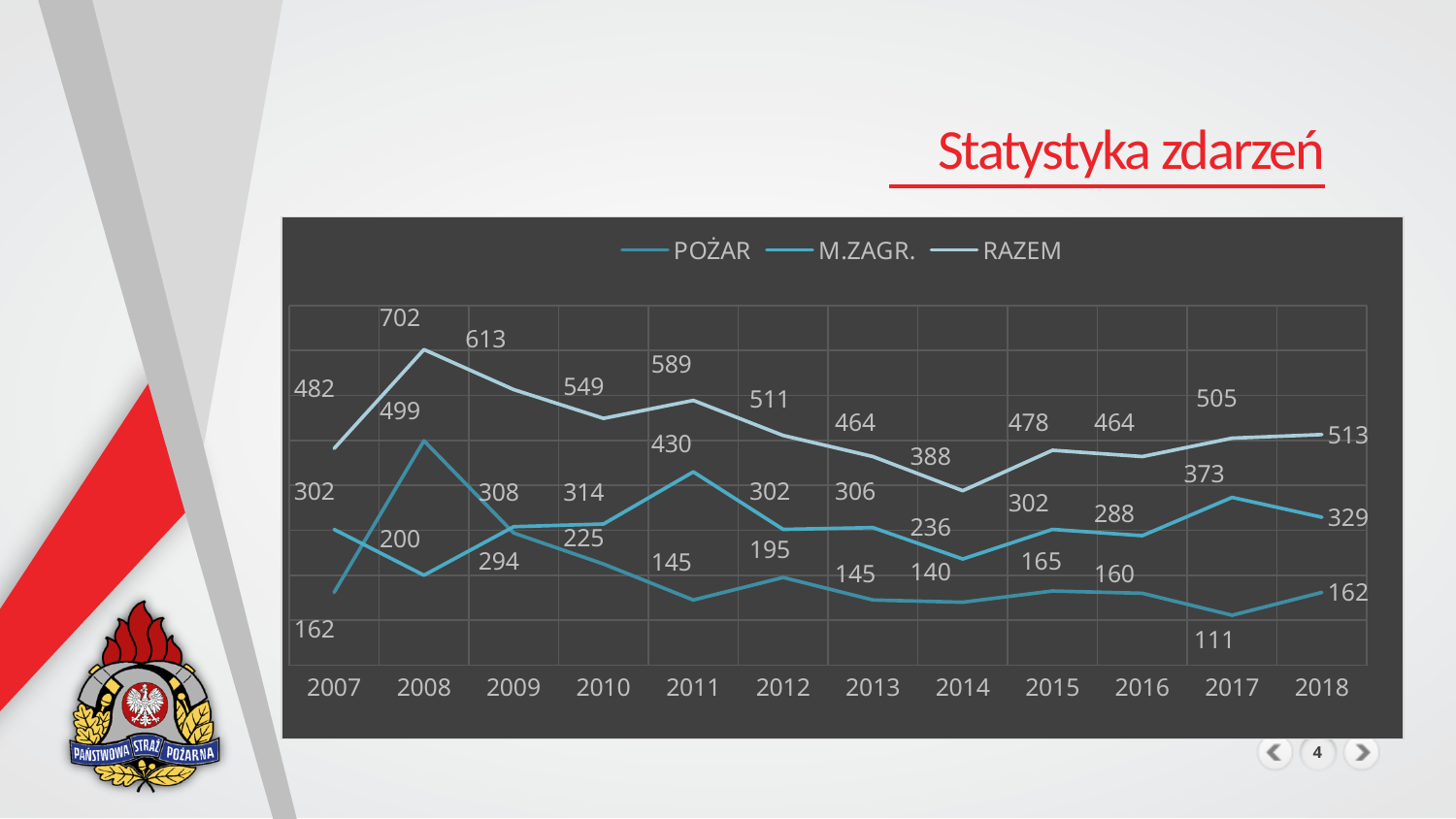
How many series does the legend list? 3 In which year is the RAZEM value lowest? 2014 What is the RAZEM value for 2018? 513 Does the RAZEM line rise or fall from 2011 to 2014? fall In which year is the RAZEM value highest? 2008 How many years are shown on the x axis? 12 What is the lowest data label shown anywhere on the chart, and in which year does it occur? 111, in 2017 Which year has the larger RAZEM value, 2017 or 2018? 2018 What are the three series names listed in the legend? POŻAR, M.ZAGR., RAZEM What is the difference between the RAZEM values for 2008 and 2014? 314 What type of chart is shown on the slide? line chart What is the RAZEM value for 2008? 702